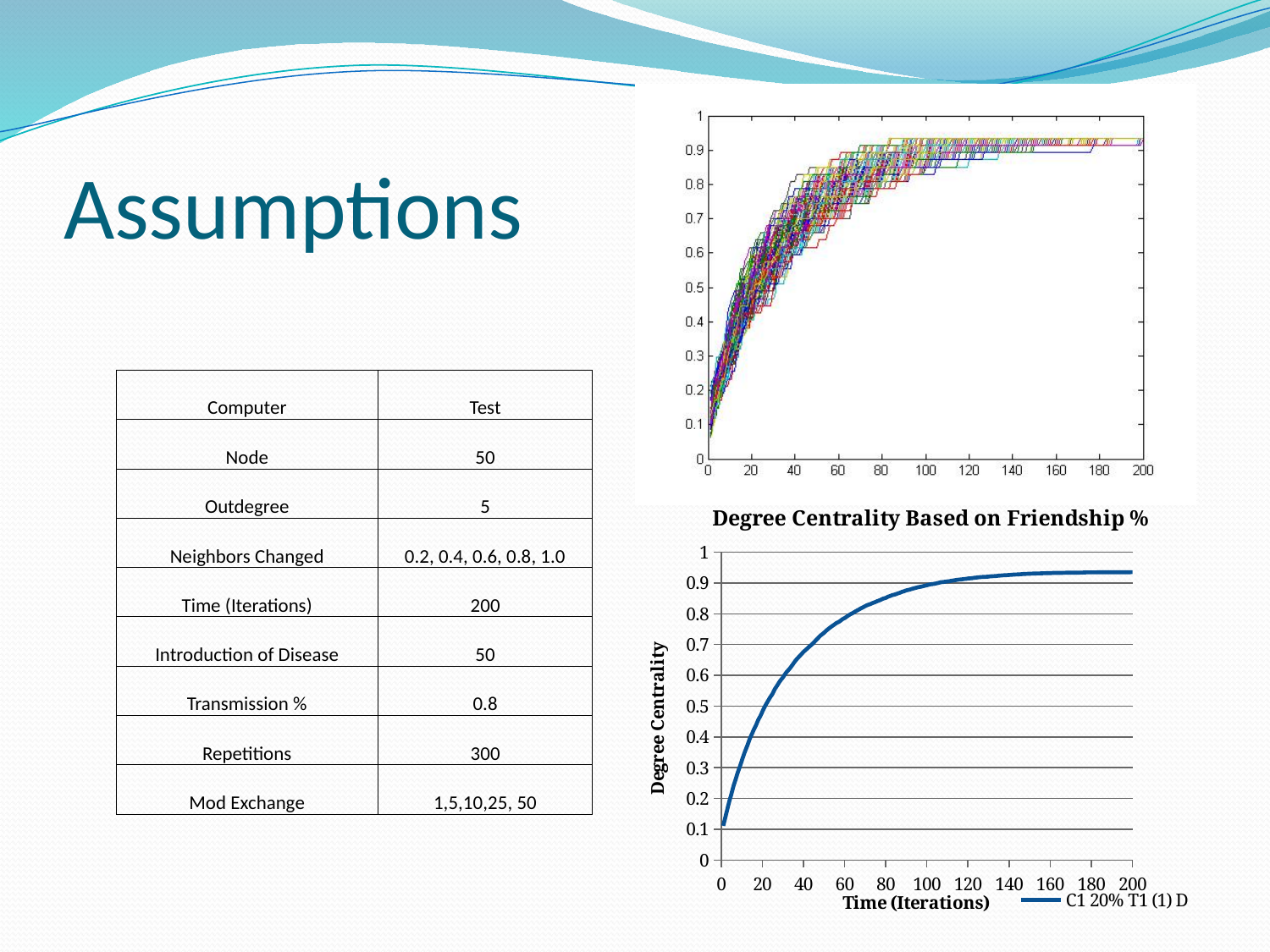
In the chart titled 'Degree Centrality Based on Friendship %', is the degree centrality at 200 iterations greater or less than 1? less What kind of chart is the top-right chart on the slide? line chart In the top-right chart, do the plotted lines generally rise or fall as the x-axis value increases from 0 to 200? rise In the chart titled 'Degree Centrality Based on Friendship %', does the degree centrality rise or fall as time (iterations) increases? rise How many series does the legend of the chart titled 'Degree Centrality Based on Friendship %' list? 1 What is the title of the bottom-right chart? Degree Centrality Based on Friendship % What is the legend entry of the chart titled 'Degree Centrality Based on Friendship %'? C1 20% T1 (1) D In the chart titled 'Degree Centrality Based on Friendship %', is the degree centrality at 40 iterations greater or less than 0.5? greater In the chart titled 'Degree Centrality Based on Friendship %', is the degree centrality at 0 iterations greater or less than 0.5? less What kind of chart is the chart titled 'Degree Centrality Based on Friendship %'? line chart